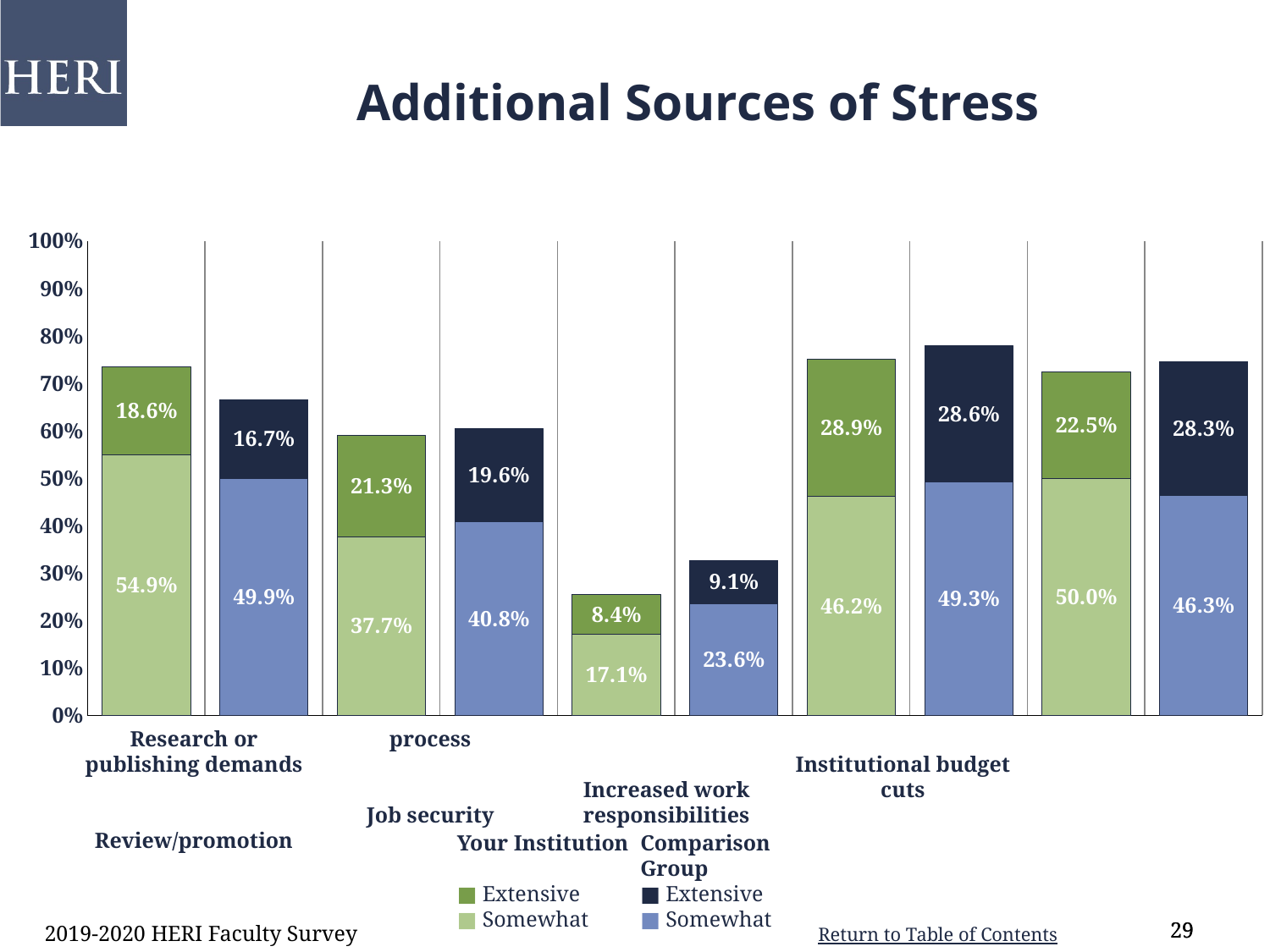
For increased work responsibilities, which is larger: the 'Somewhat' value for Your Institution or for the Comparison Group? Comparison Group How many sources of stress are shown on the x axis? 5 What is the 'Somewhat' value for the Comparison Group on job security? 23.6% What percentage of Your Institution faculty reported research or publishing demands as a 'Somewhat' source of stress? 54.9% What type of chart is shown on the slide? Stacked bar chart What is the 'Extensive' value for the Comparison Group on institutional budget cuts? 28.3% Which source of stress has the highest 'Somewhat' value for Your Institution? Research or publishing demands What is the difference between the Your Institution and Comparison Group 'Extensive' values for the review/promotion process? 1.7% What is the total height of the Comparison Group stacked bar for research or publishing demands? 66.6% Which source of stress has the lowest 'Extensive' value for Your Institution? Job security How many entries does the legend list? 4 What is the total height of the Your Institution stacked bar for job security? 25.5%